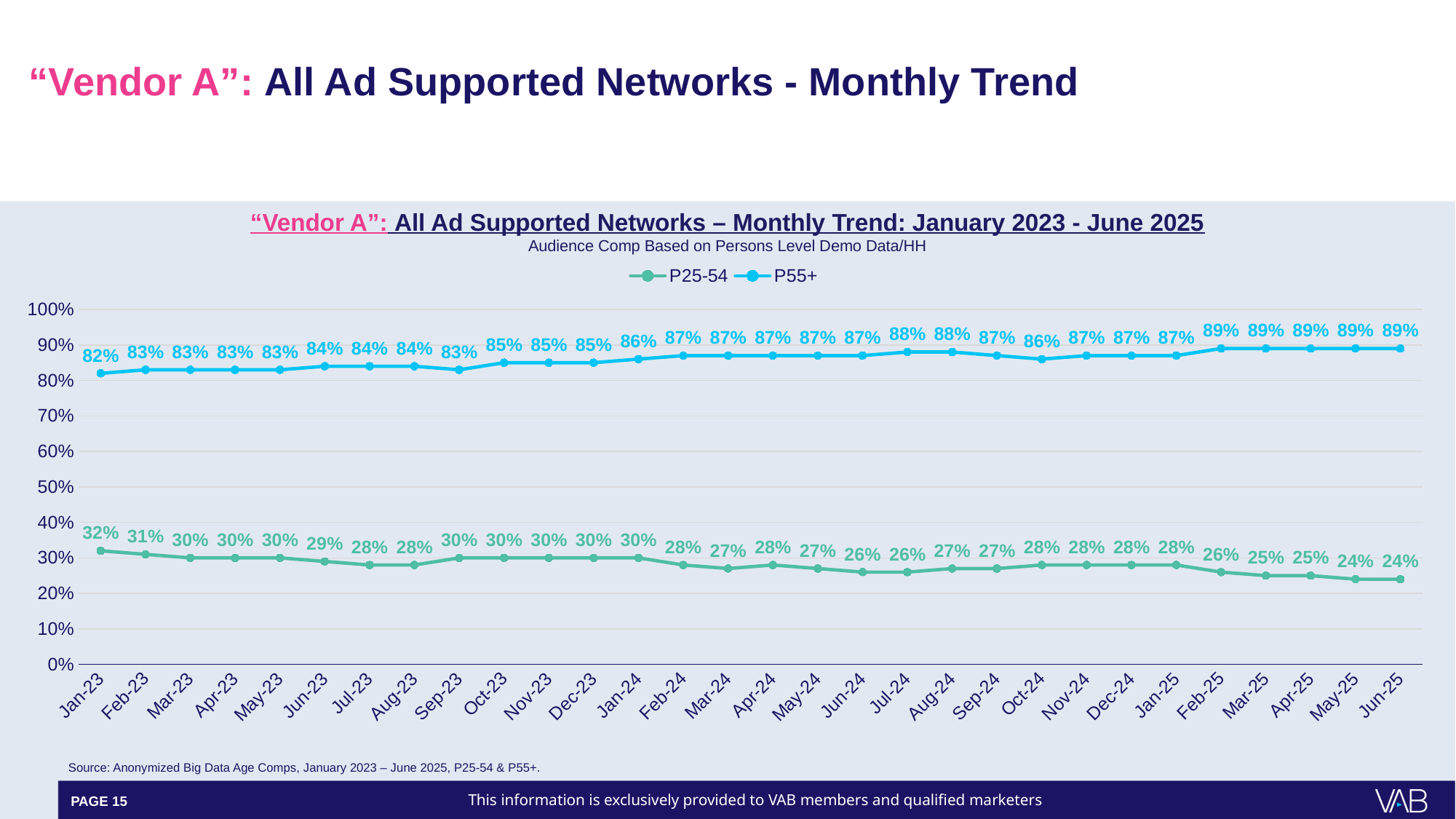
What is the P25-54 value for Oct-24? 28% What is the difference between the P55+ and P25-54 values in Jun-25? 65% What is the P25-54 value for Jun-25? 24% What kind of chart is shown on the slide? Line chart Does the P55+ series generally rise or fall from Jan-23 to Jun-25? Rise Which is larger, the P25-54 value for Jan-23 or for Jun-25? Jan-23 What is the P55+ value for Jan-23? 82% How many months are plotted on the x axis? 30 What is the P55+ value for Oct-24? 86% How many series does the legend list? 2 In which month is the P25-54 series at its highest? Jan-23 What is the lowest value shown for the P55+ series? 82%